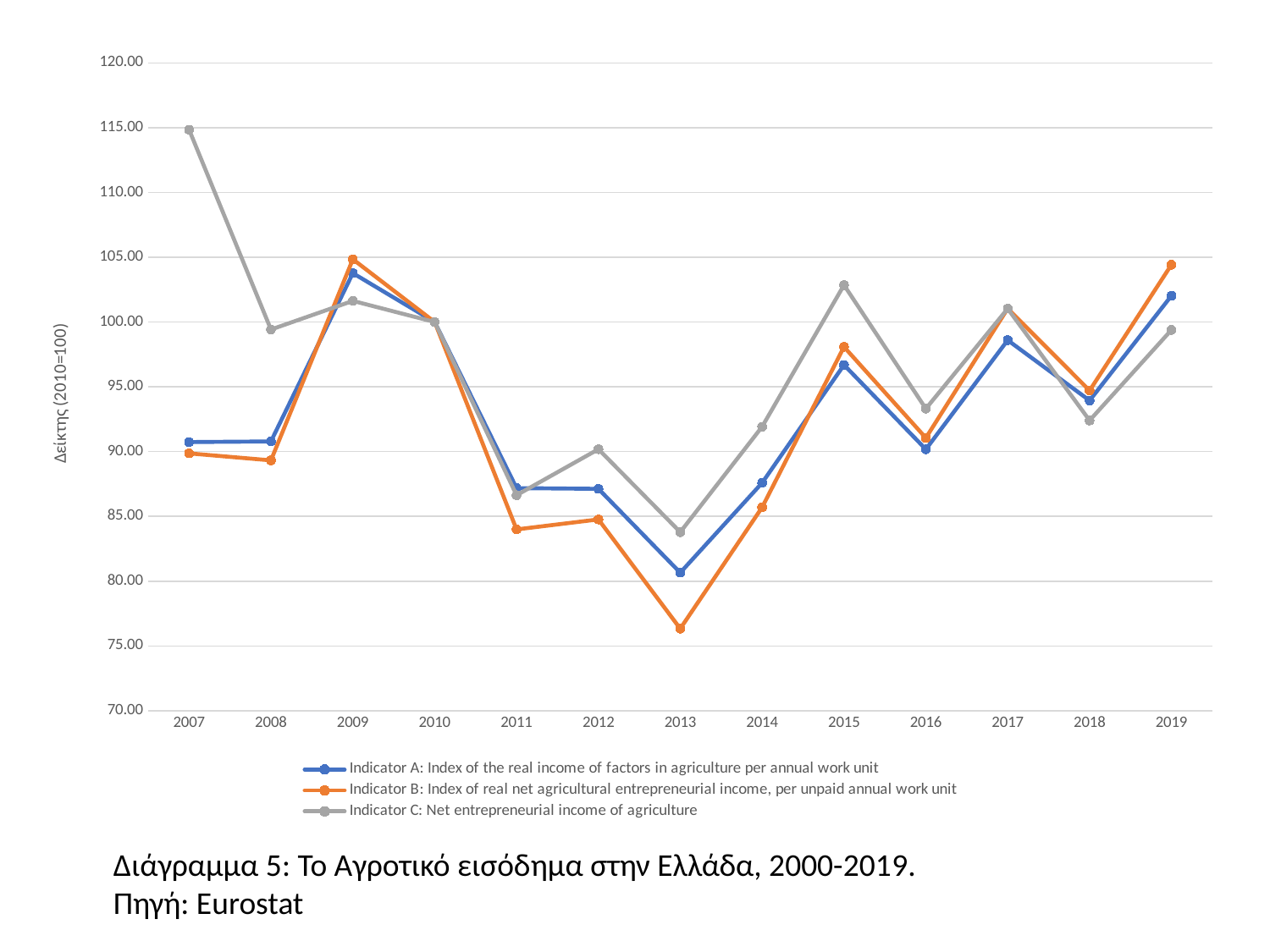
What kind of chart is shown on the slide? line chart What is the source cited below the chart? Eurostat Does Indicator C rise or fall from 2007 to 2008? fall How many series does the legend list? 3 In 2013, which is larger: Indicator C or Indicator B? Indicator C Is the value of Indicator C in 2015 greater or less than 100? greater Is the value of Indicator B in 2013 greater or less than 80? less In which year does Indicator C reach its highest value? 2007 In which year does Indicator B reach its lowest value? 2013 Is the value of Indicator C in 2007 greater or less than 110? greater How many years are plotted along the x axis? 13 What is the value of all three indicators in 2010? 100.00